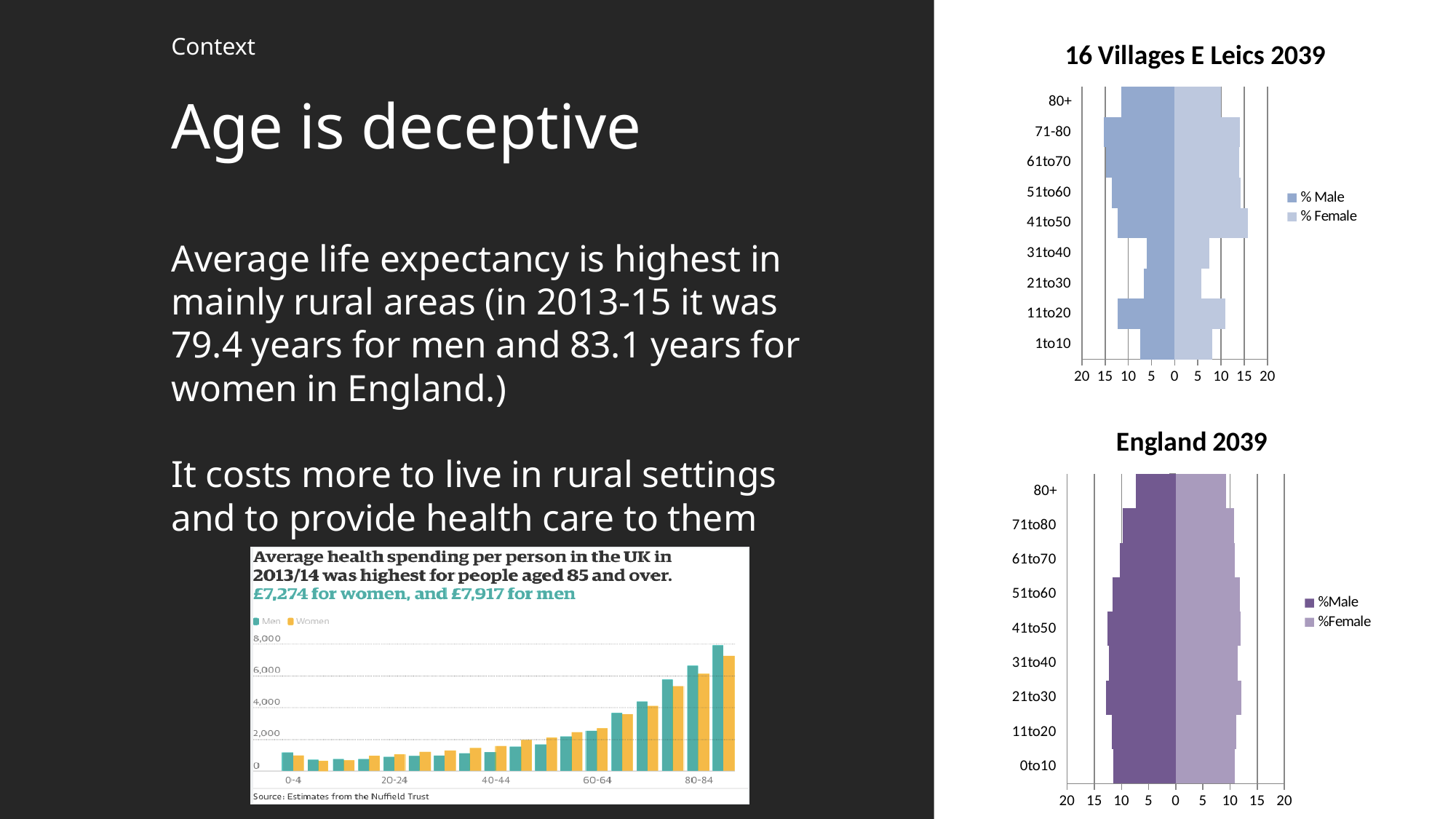
How many age categories are shown on the 'England 2039' chart? 9 How many age categories are shown on the '16 Villages E Leics 2039' chart? 9 In the '16 Villages E Leics 2039' chart, which is larger for the 71-80 age group, % Male or % Female? % Male What kind of chart is the '16 Villages E Leics 2039' chart? bar chart How many series does the legend of the '16 Villages E Leics 2039' chart list? 2 In the '16 Villages E Leics 2039' chart, which age group has the largest % Female bar? 41to50 In the health spending chart at the bottom left, do the values generally rise or fall as age increases? rise What are the two legend entries on the 'England 2039' chart? %Male and %Female In the health spending chart at the bottom left, what is the difference between spending for men and women aged 85 and over? £643 In the '16 Villages E Leics 2039' chart, is the % Male value for 21to30 greater or less than 10? less In the health spending chart at the bottom left, what was the average health spending per person for men aged 85 and over in 2013/14? £7,917 In the 'England 2039' chart, is the %Male value for 80+ greater or less than 10? less